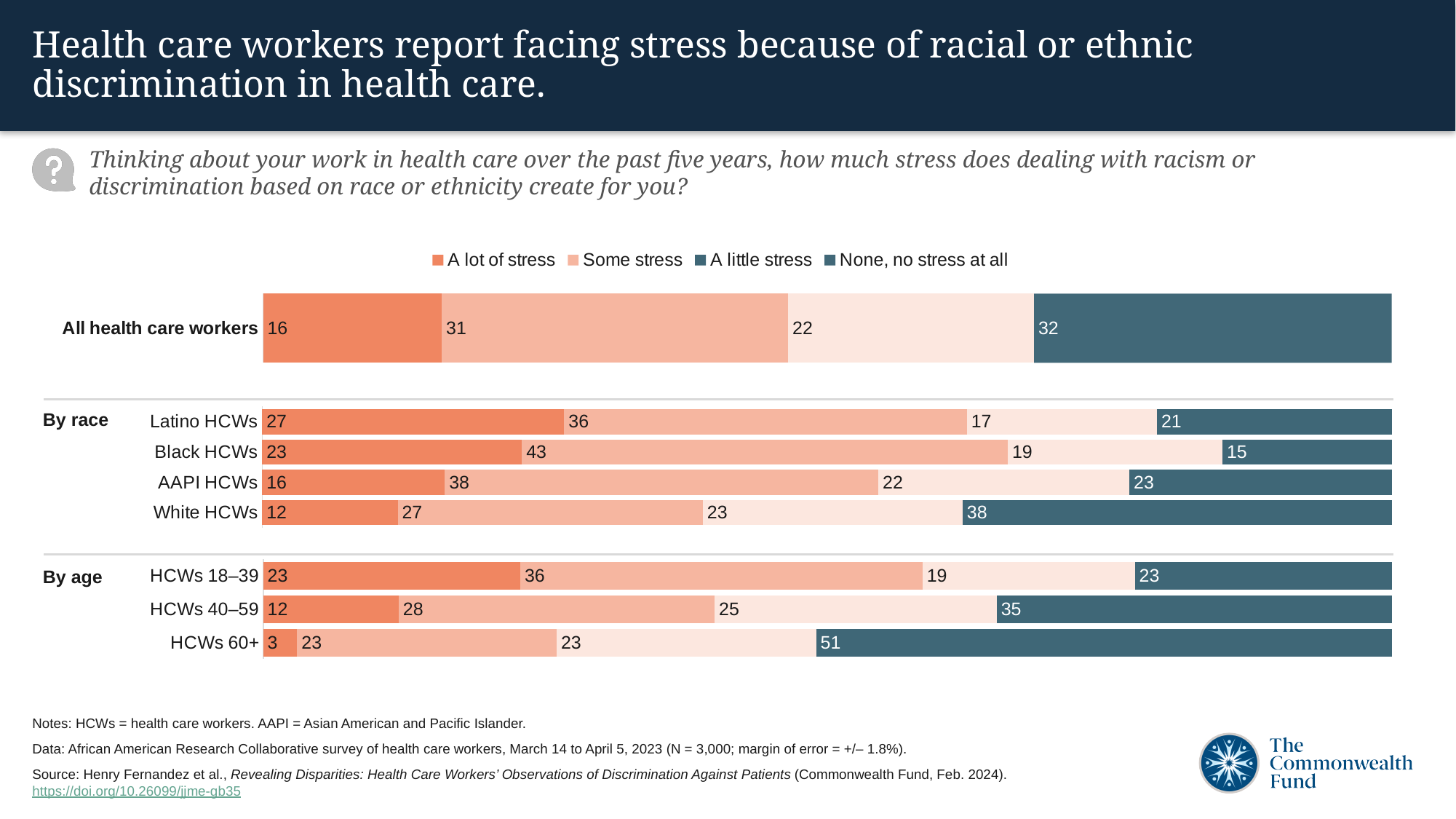
What is the value for "None, no stress at all" among HCWs 60+? 51 What is the difference between the "None, no stress at all" values for White HCWs and Black HCWs? 23 Which age group has the lowest value for "A lot of stress"? HCWs 60+ What kind of chart is shown on the slide? Stacked bar chart What is the total of the stacked bar for HCWs 40–59? 100 Which is larger: the "Some stress" value for Latino HCWs or for AAPI HCWs? AAPI HCWs How many series does the legend list? 4 What is the value for "Some stress" among Black HCWs? 43 Which race group has the highest value for "A lot of stress"? Latino HCWs How many bars are shown in the chart in total? 8 What is the value for "A lot of stress" among All health care workers? 16